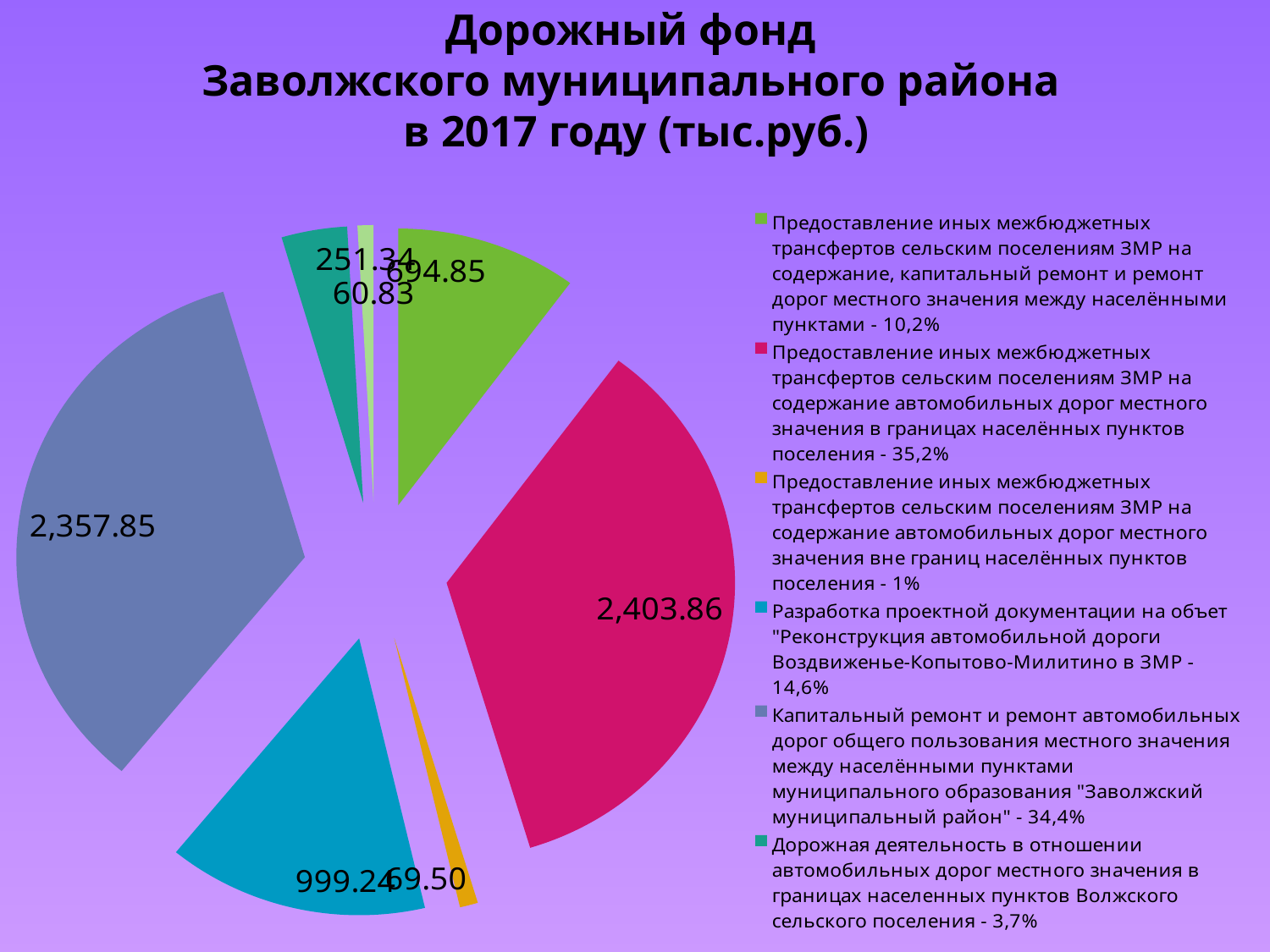
How many entries does the legend list? 6 Which slice has the largest value in the pie chart? Предоставление иных межбюджетных трансфертов сельским поселениям ЗМР на содержание автомобильных дорог местного значения в границах населённых пунктов поселения (2,403.86) What is the value of the slice for 'Разработка проектной документации на объект "Реконструкция автомобильной дороги Воздвиженье-Копытово-Милитино в ЗМР"'? 999.24 What is the difference between the slice labelled 999.24 and the slice labelled 694.85? 304.39 What is the value of the slice for 'Предоставление иных межбюджетных трансфертов сельским поселениям ЗМР на содержание, капитальный ремонт и ремонт дорог местного значения между населёнными пунктами'? 694.85 What is the value of the slice for 'Предоставление иных межбюджетных трансфертов сельским поселениям ЗМР на содержание автомобильных дорог местного значения вне границ населённых пунктов поселения'? 69.50 What is the value of the slice for 'Дорожная деятельность в отношении автомобильных дорог местного значения в границах населенных пунктов Волжского сельского поселения'? 251.34 What is the value of the slice for 'Капитальный ремонт и ремонт автомобильных дорог общего пользования местного значения между населёнными пунктами муниципального образования "Заволжский муниципальный район"'? 2,357.85 What is the difference between the slice labelled 2,403.86 and the slice labelled 2,357.85? 46.01 What type of chart is shown on the slide? pie chart What is the value of the slice for 'Предоставление иных межбюджетных трансфертов сельским поселениям ЗМР на содержание автомобильных дорог местного значения в границах населённых пунктов поселения'? 2,403.86 According to the legend, what share of the pie does 'Капитальный ремонт и ремонт автомобильных дорог общего пользования местного значения между населёнными пунктами' represent? 34,4%